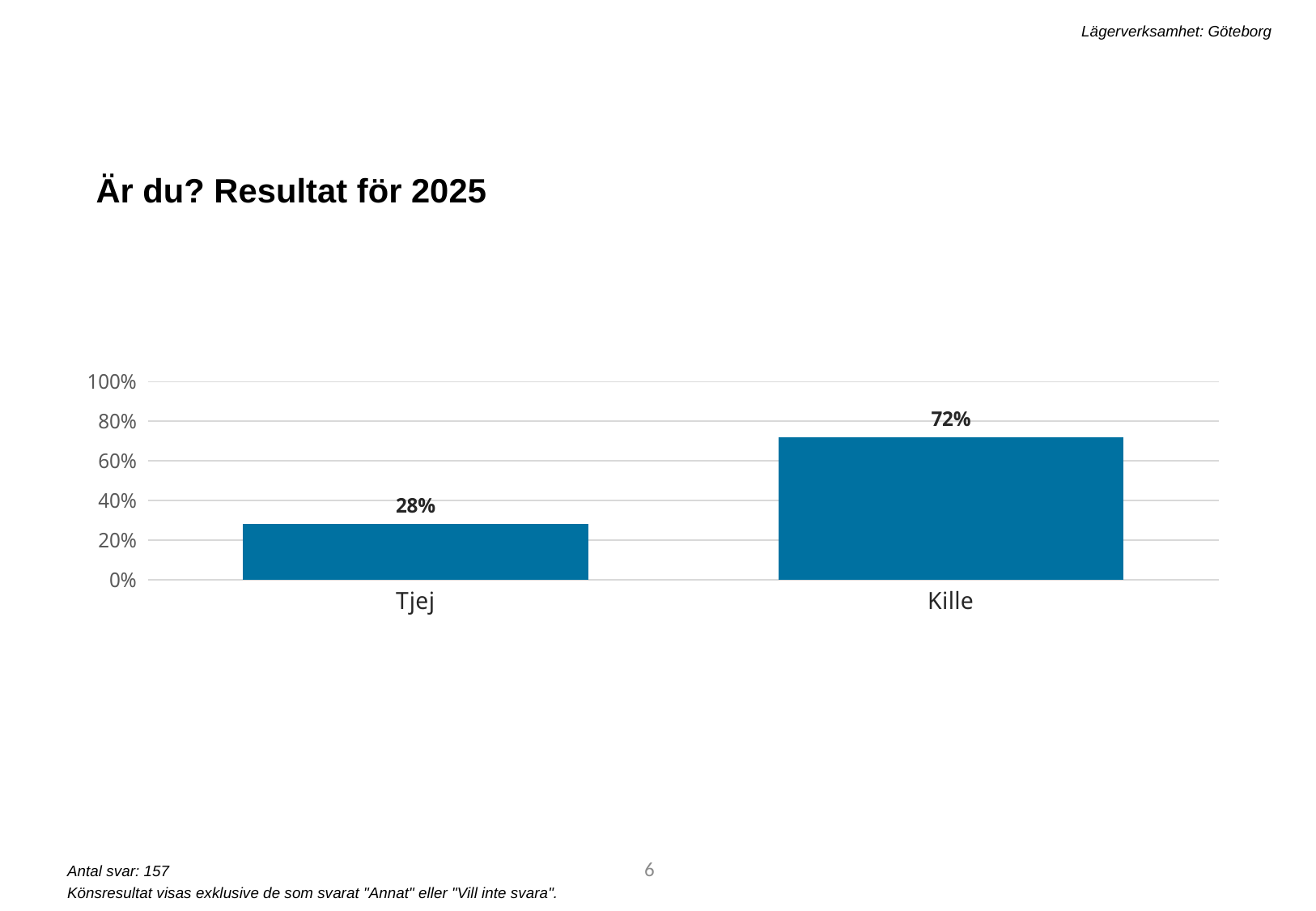
What is the value for Tjej? 28% What kind of chart is shown on the slide? bar chart Which is larger, the value for Tjej or the value for Kille? Kille Which category has the lowest value? Tjej What is the value for Kille? 72% What is the title of the slide? Är du? Resultat för 2025 What is the highest value shown on the y axis? 100% Which category has the highest value? Kille Is the value for Kille greater or less than 60%? greater How many categories are shown on the x axis? 2 Is the value for Tjej greater or less than 40%? less What is the difference between the values for Kille and Tjej? 44%